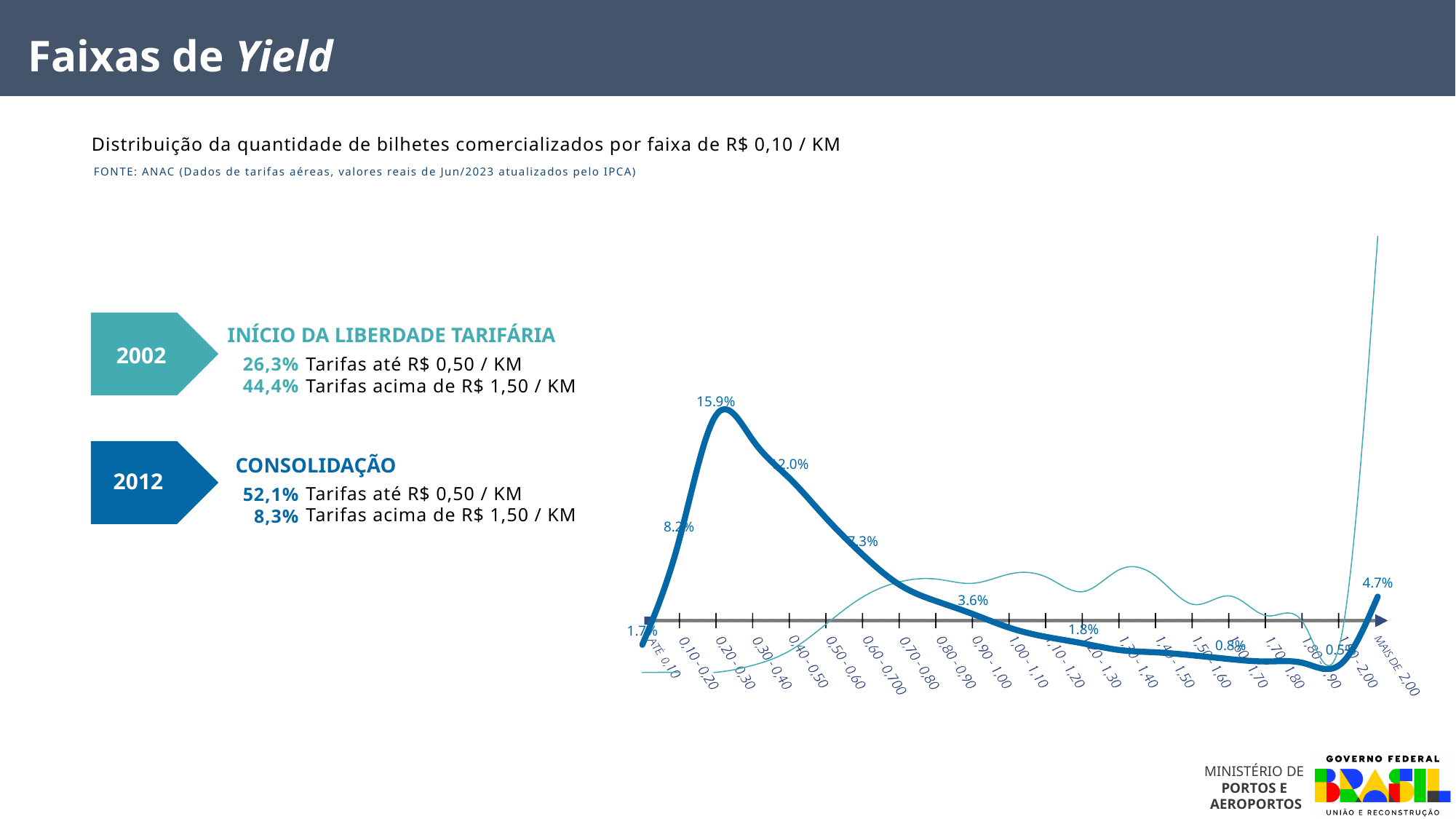
What is the value labelled on the thick dark blue line for the band 'Até 0,10'? 1.7% How many bands are listed along the x axis of the chart? 21 What is the difference between the labelled values 15.9% and 8.2% on the thick dark blue line? 7.7 percentage points What is the lowest labelled value on the thick dark blue line? 0.5% Does the thick dark blue line rise or fall between the band '0,20 - 0,30' and the band '1,90 - 2,00'? fall What kind of chart is shown on the slide? line chart How many lines are plotted on the chart? 2 What is the value labelled on the thick dark blue line for the band '0,10 - 0,20'? 8.2% On the thick dark blue line, which is larger: the value for '0,20 - 0,30' or the value for 'Mais de 2,00'? 0,20 - 0,30 What is the value labelled on the thick dark blue line for the band 'Mais de 2,00'? 4.7% Which x-axis band has the peak value of 15.9% on the thick dark blue line? 0,20 - 0,30 What is the highest labelled value on the thick dark blue line? 15.9%